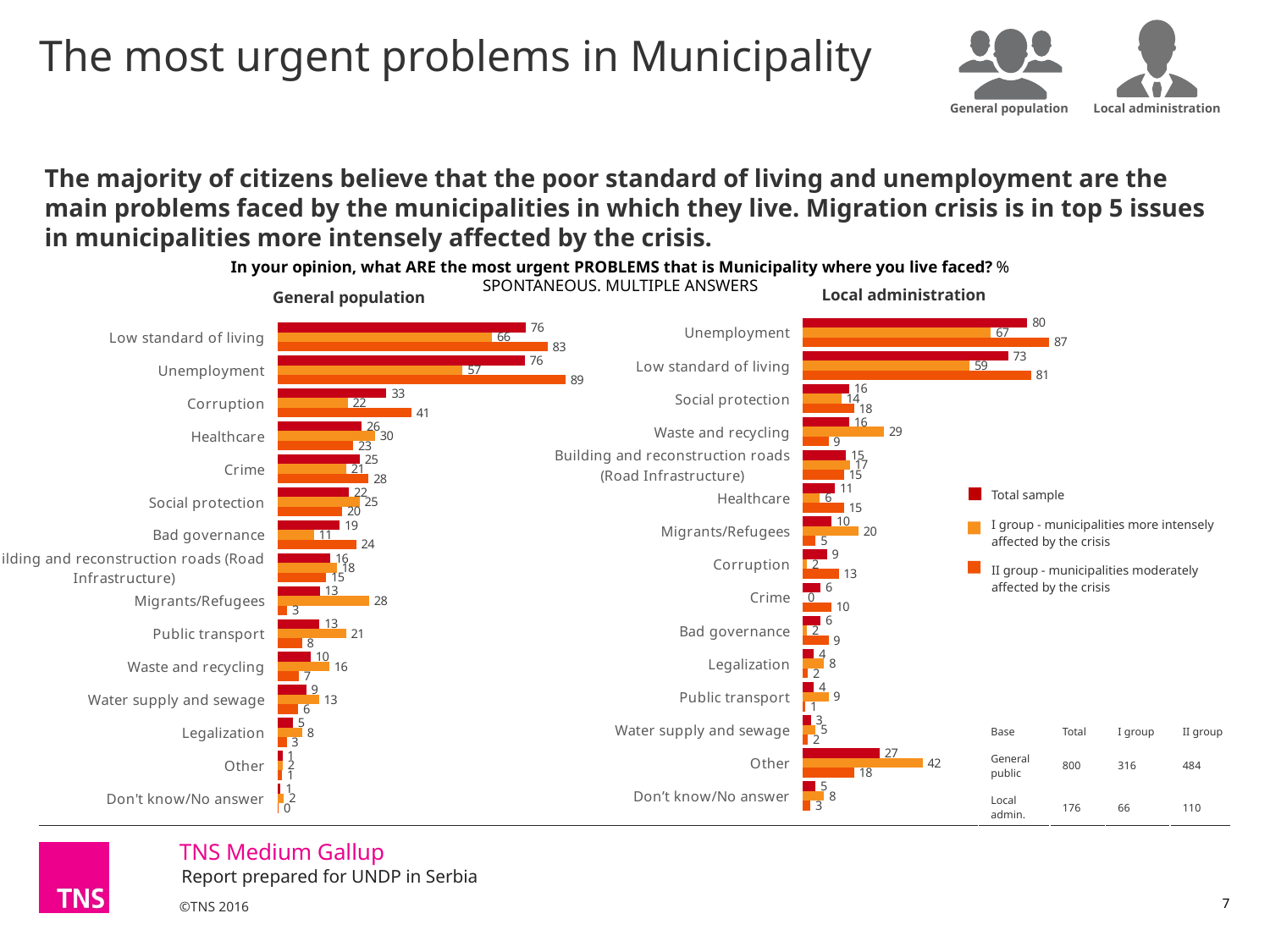
In the Local administration chart, what is the I group value for Waste and recycling? 29 In the Local administration chart, which is larger for Corruption: the I group value or the II group value? II group In the Local administration chart, what is the difference between the Total sample values for Unemployment and Low standard of living? 7 How many series does the legend list for the Local administration chart? 3 In the General population chart, what is the difference between the I group and II group values for Migrants/Refugees? 25 In the General population chart, what is the II group value for Unemployment? 89 In the Local administration chart, what is the Total sample value for Unemployment? 80 In the Local administration chart, which category has the highest I group value? Unemployment In the General population chart, what is the Total sample value for Corruption? 33 What type of chart is the General population chart? Bar chart In the General population chart, which category has the lowest II group value? Don't know/No answer How many categories are shown in the General population chart? 15